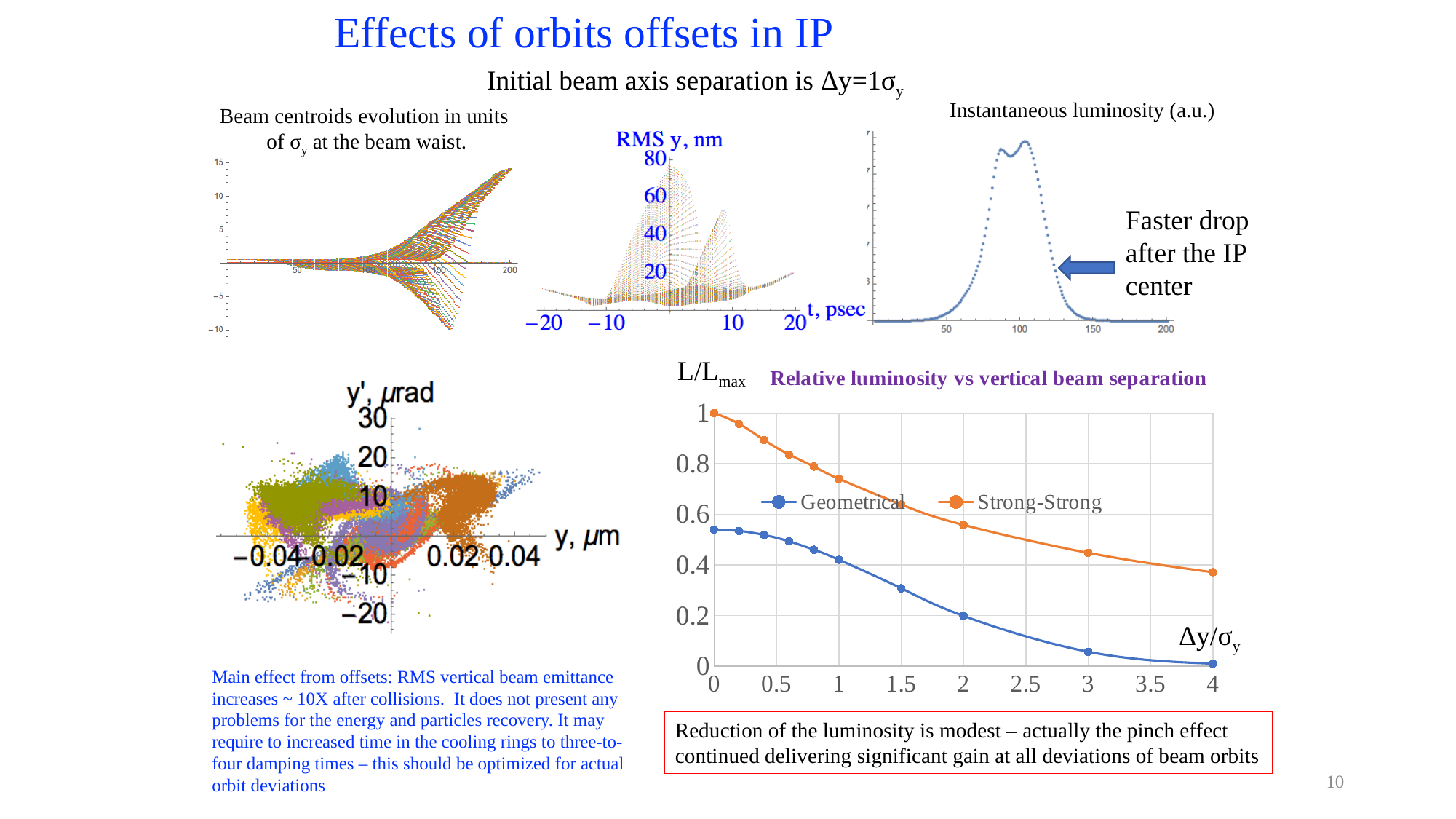
On the 'Relative luminosity vs vertical beam separation' chart, which series has the larger value at Δy/σy = 2, Geometrical or Strong-Strong? Strong-Strong On the 'Relative luminosity vs vertical beam separation' chart, what kind of chart is it? line chart On the 'Relative luminosity vs vertical beam separation' chart, is the Geometrical value at Δy/σy = 3 greater or less than 0.2? less On the 'Relative luminosity vs vertical beam separation' chart, is the Geometrical value at Δy/σy = 0 greater or less than 0.5? greater On the 'Relative luminosity vs vertical beam separation' chart, is the Strong-Strong value at Δy/σy = 2 greater or less than 0.5? greater On the 'Relative luminosity vs vertical beam separation' chart, what are the two series named in the legend? Geometrical and Strong-Strong On the 'Relative luminosity vs vertical beam separation' chart, how many series does the legend list? 2 On the 'Relative luminosity vs vertical beam separation' chart, how many data points are plotted for the Geometrical series? 10 On the 'Relative luminosity vs vertical beam separation' chart, do the Geometrical values rise or fall as Δy/σy increases? fall On the 'Relative luminosity vs vertical beam separation' chart, what is the L/Lmax value of the Strong-Strong series at Δy/σy = 0? 1